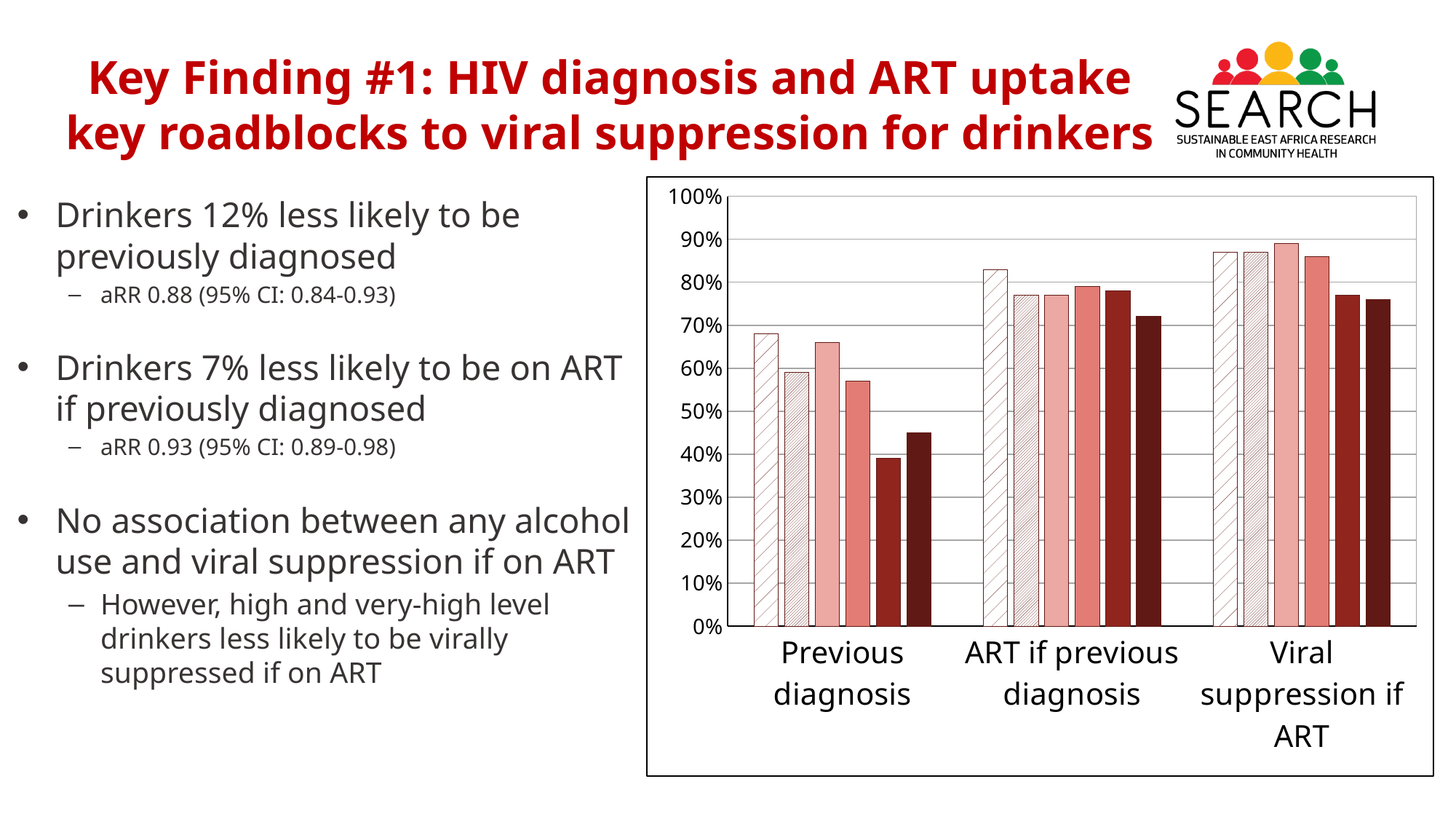
How many categories are shown on the x axis of the chart? 3 Is the value of the leftmost bar in the 'Previous diagnosis' group greater or less than 60%? greater In the 'ART if previous diagnosis' group, which is larger: the leftmost bar or the rightmost bar? the leftmost bar Which category on the x axis has the tallest bars overall? Viral suppression if ART Is the value of the rightmost (darkest) bar in the 'ART if previous diagnosis' group greater or less than 80%? less What kind of chart is shown on the slide? bar chart Is the value of the leftmost bar in the 'Viral suppression if ART' group greater or less than 80%? greater Do the bar heights generally rise or fall moving from 'Previous diagnosis' to 'Viral suppression if ART' along the x axis? rise Which category on the x axis has the shortest bars overall? Previous diagnosis How many bars are plotted in each category group of the chart? 6 What is the maximum value shown on the chart's y axis? 100%